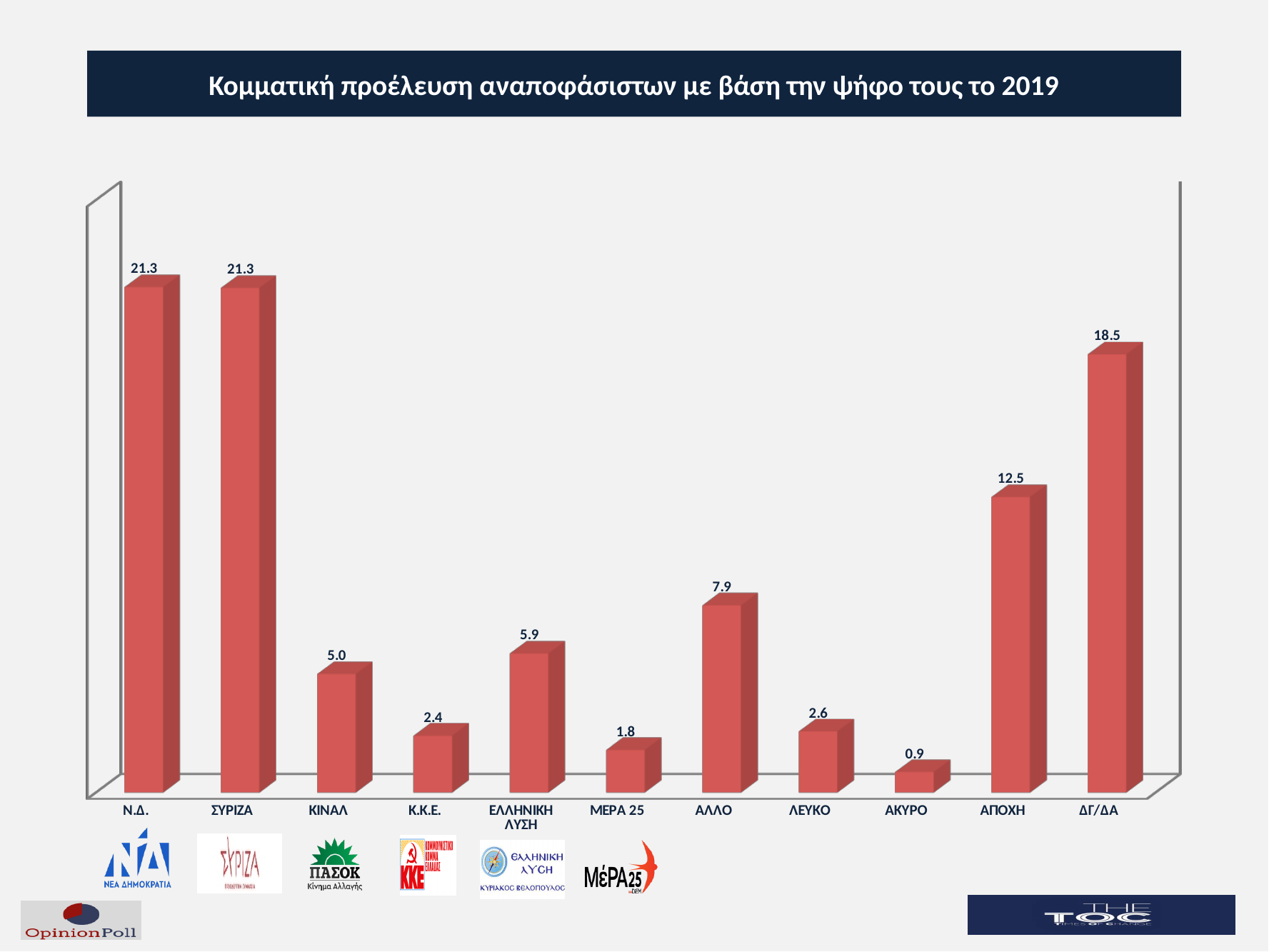
Which is larger, the value for ΛΕΥΚΟ or the value for Κ.Κ.Ε.? ΛΕΥΚΟ What is the value for ΔΓ/ΔΑ? 18.5 What kind of chart is shown on the slide? Bar chart What is the difference between the values for ΑΛΛΟ and ΚΙΝΑΛ? 2.9 Which is larger, the value for ΑΠΟΧΗ or the value for ΑΛΛΟ? ΑΠΟΧΗ What is the value for ΑΠΟΧΗ? 12.5 What is the value for ΕΛΛΗΝΙΚΗ ΛΥΣΗ? 5.9 How many categories are shown on the chart? 11 What is the value for Ν.Δ.? 21.3 What is the value for ΜΕΡΑ 25? 1.8 Which category has the lowest value? ΑΚΥΡΟ What is the difference between the values for ΔΓ/ΔΑ and ΑΠΟΧΗ? 6.0